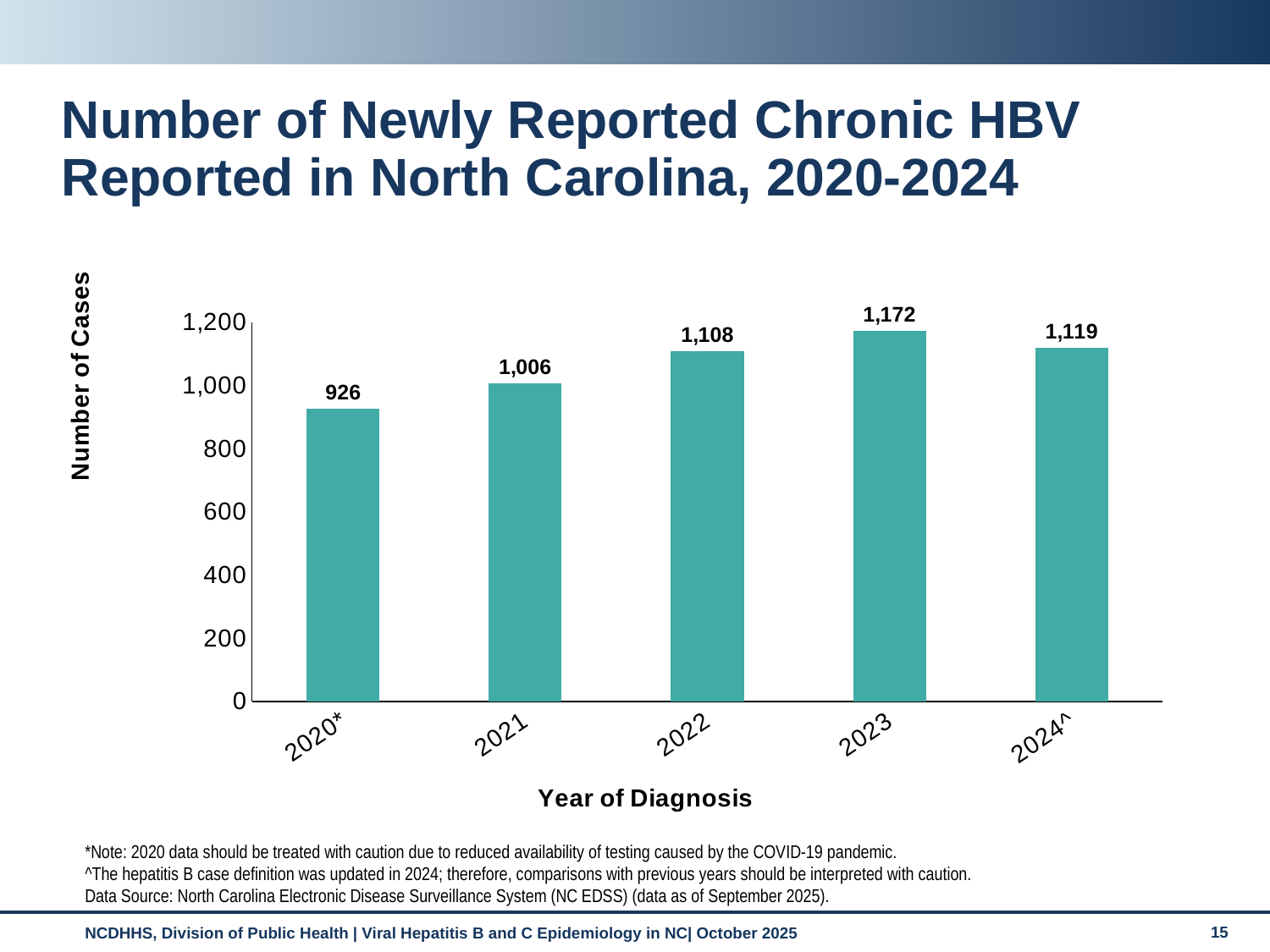
Which year has the lowest number of cases? 2020 What is the difference in cases between 2023 and 2020? 246 What kind of chart is shown on the slide? Bar chart What is the label of the y axis? Number of Cases Which year had more cases, 2022 or 2024? 2024 Is the value for 2021 greater or less than 1,000? greater What is the number of cases for 2023? 1,172 What is the difference in cases between 2022 and 2021? 102 What is the number of cases for 2024? 1,119 How many newly reported chronic HBV cases were there in 2020? 926 Which year has the highest number of cases? 2023 How many years are shown on the x axis? 5